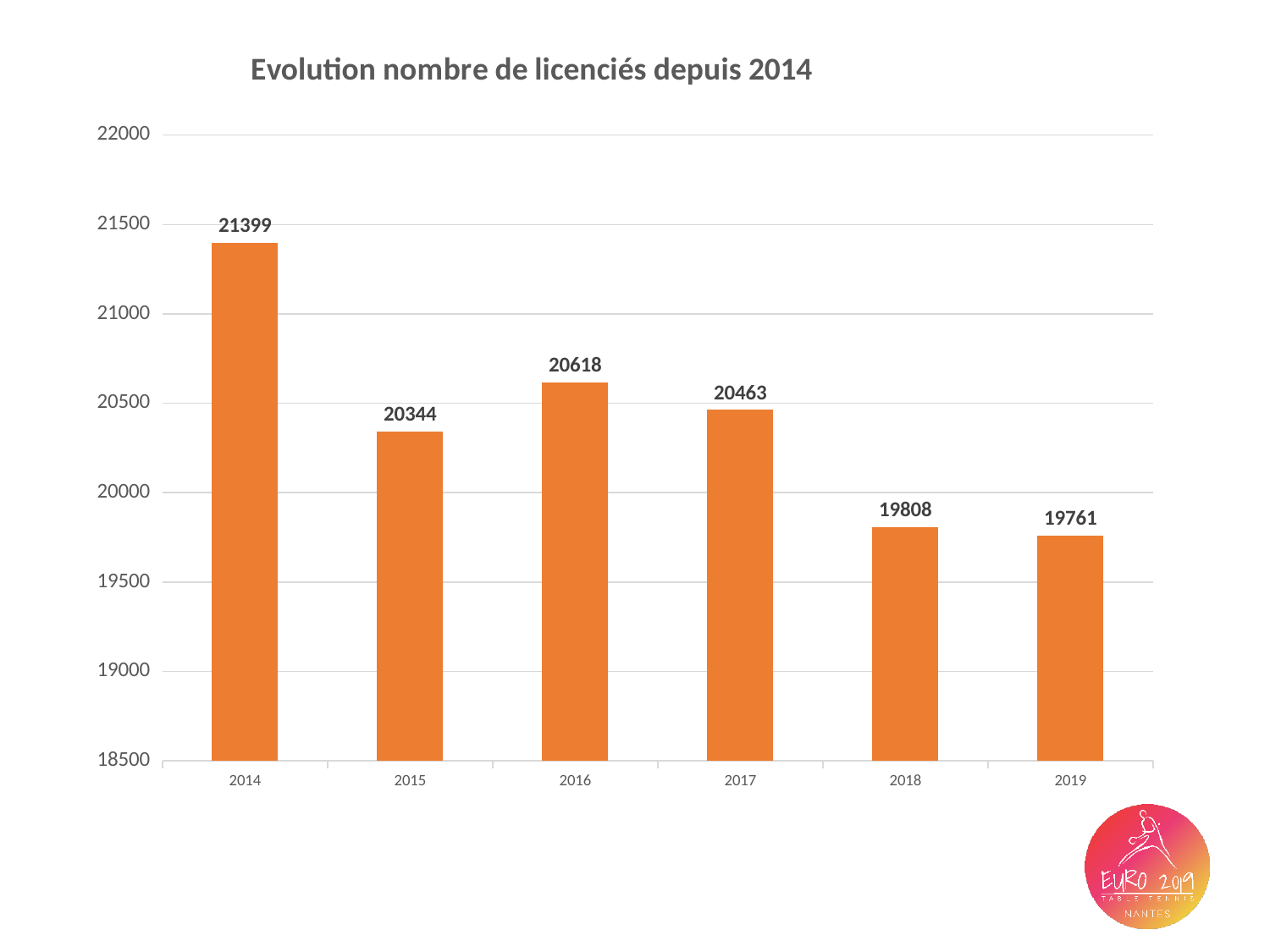
What is the value for 2014? 21399 How many years are shown on the x axis? 6 Which year has the highest value? 2014 What is the difference between the values for 2018 and 2019? 47 What is the value for 2019? 19761 What kind of chart is this? bar chart What is the difference between the values for 2014 and 2015? 1055 What is the value for 2017? 20463 Which is larger, the value for 2016 or the value for 2017? 2016 Which year has the lowest value? 2019 Is the value for 2018 greater or less than 20000? less What is the title of the chart? Evolution nombre de licenciés depuis 2014